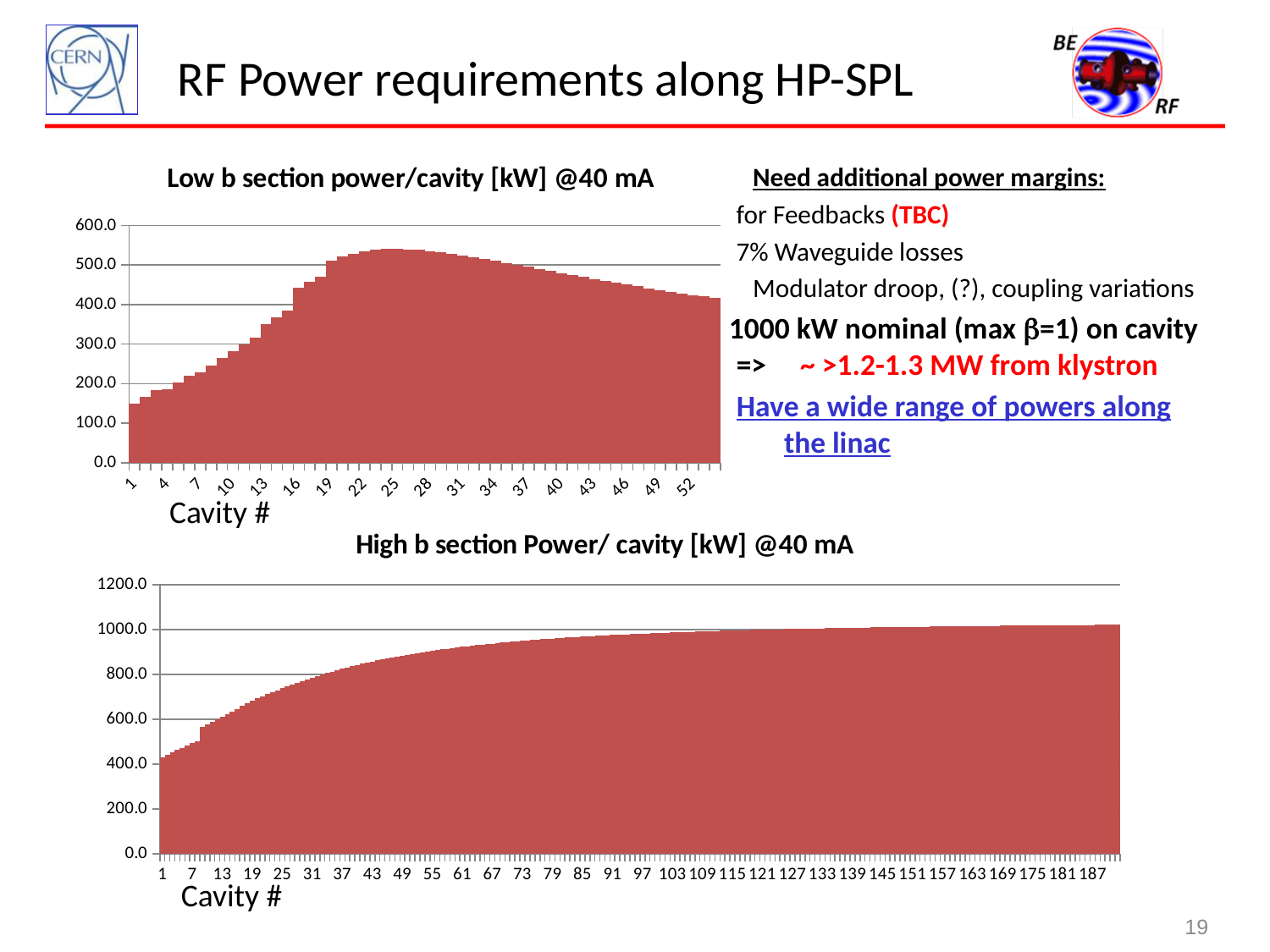
In the 'Low b section power/cavity [kW] @40 mA' chart, do the values rise or fall from cavity 1 to cavity 16? rise What is the x-axis label of the 'High b section Power/ cavity [kW] @40 mA' chart? Cavity # In the 'Low b section power/cavity [kW] @40 mA' chart, is the value for cavity 1 greater or less than 200? less In the 'Low b section power/cavity [kW] @40 mA' chart, is the value for cavity 52 greater or less than 300? greater In the 'High b section Power/ cavity [kW] @40 mA' chart, which has the larger value, cavity 7 or cavity 97? cavity 97 In the 'High b section Power/ cavity [kW] @40 mA' chart, is the value for cavity 1 greater or less than 600? less In the 'Low b section power/cavity [kW] @40 mA' chart, which has the larger value, cavity 7 or cavity 40? cavity 40 In the 'High b section Power/ cavity [kW] @40 mA' chart, do the values generally rise or fall along the x axis? rise What kind of chart is the 'Low b section power/cavity [kW] @40 mA' chart? bar chart What kind of chart is the 'High b section Power/ cavity [kW] @40 mA' chart? bar chart